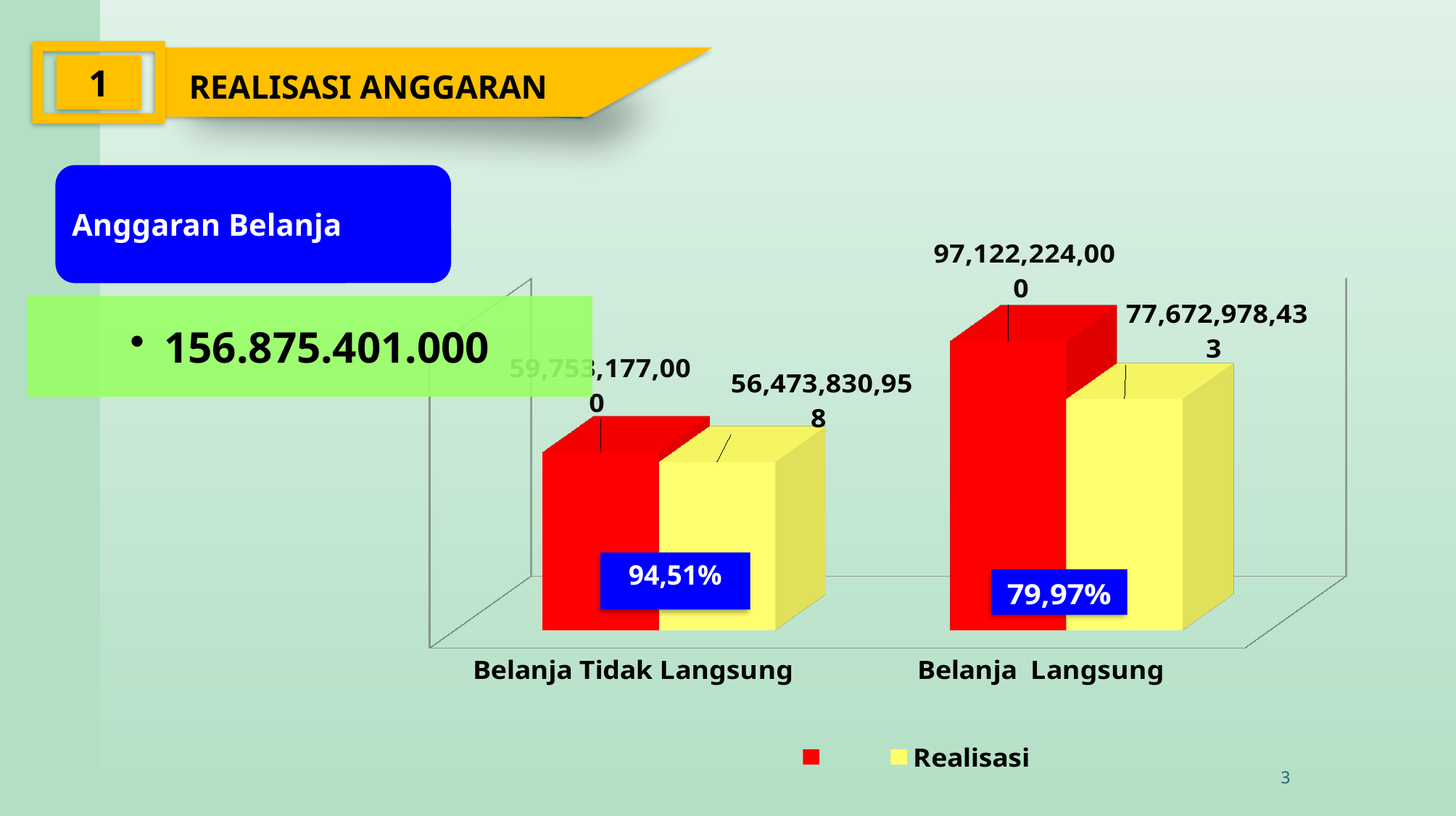
What is the value of the red bar for Belanja Langsung? 97,122,224,000 What is the difference between the red bar and the Realisasi bar for Belanja Langsung? 19,449,245,567 How many series does the chart's legend list? 2 What is the Realisasi value for Belanja Langsung? 77,672,978,433 Which category has the higher Realisasi value? Belanja Langsung What is the difference between the Realisasi values for Belanja Langsung and Belanja Tidak Langsung? 21,199,147,475 What percentage is shown on the chart for Belanja Tidak Langsung? 94,51% How many categories are shown on the x axis of the chart? 2 For Belanja Langsung, which is larger: the red bar or the Realisasi bar? the red bar What is the Realisasi value for Belanja Tidak Langsung? 56,473,830,958 What colour represents the Realisasi series in the chart? yellow What type of chart is shown on the slide? bar chart